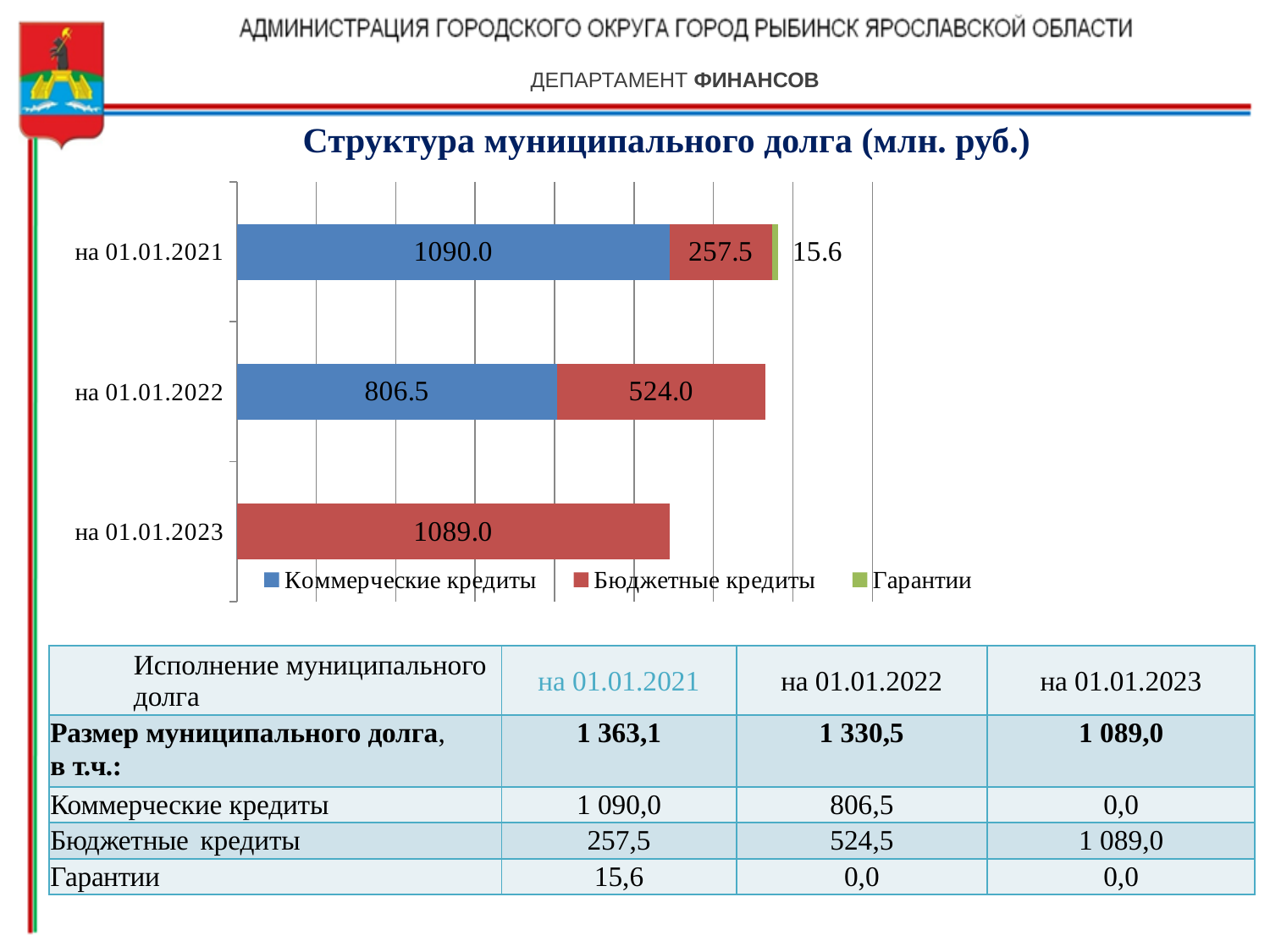
How many categories (dates) are shown on the chart? 3 What is the total of the stacked bar for на 01.01.2021? 1363.1 What is the value of Коммерческие кредиты на 01.01.2021? 1090.0 What is the value of Гарантии на 01.01.2021? 15.6 What is the value of Бюджетные кредиты на 01.01.2023? 1089.0 What type of chart is shown on the slide? Stacked bar chart Which is larger: Бюджетные кредиты на 01.01.2022 or Бюджетные кредиты на 01.01.2021? на 01.01.2022 What is the title of the chart? Структура муниципального долга (млн. руб.) What is the total of the stacked bar for на 01.01.2022? 1330.5 What is the difference between Коммерческие кредиты на 01.01.2021 and на 01.01.2022? 283.5 How many series does the legend list? 3 What is the value of Бюджетные кредиты на 01.01.2022? 524.0